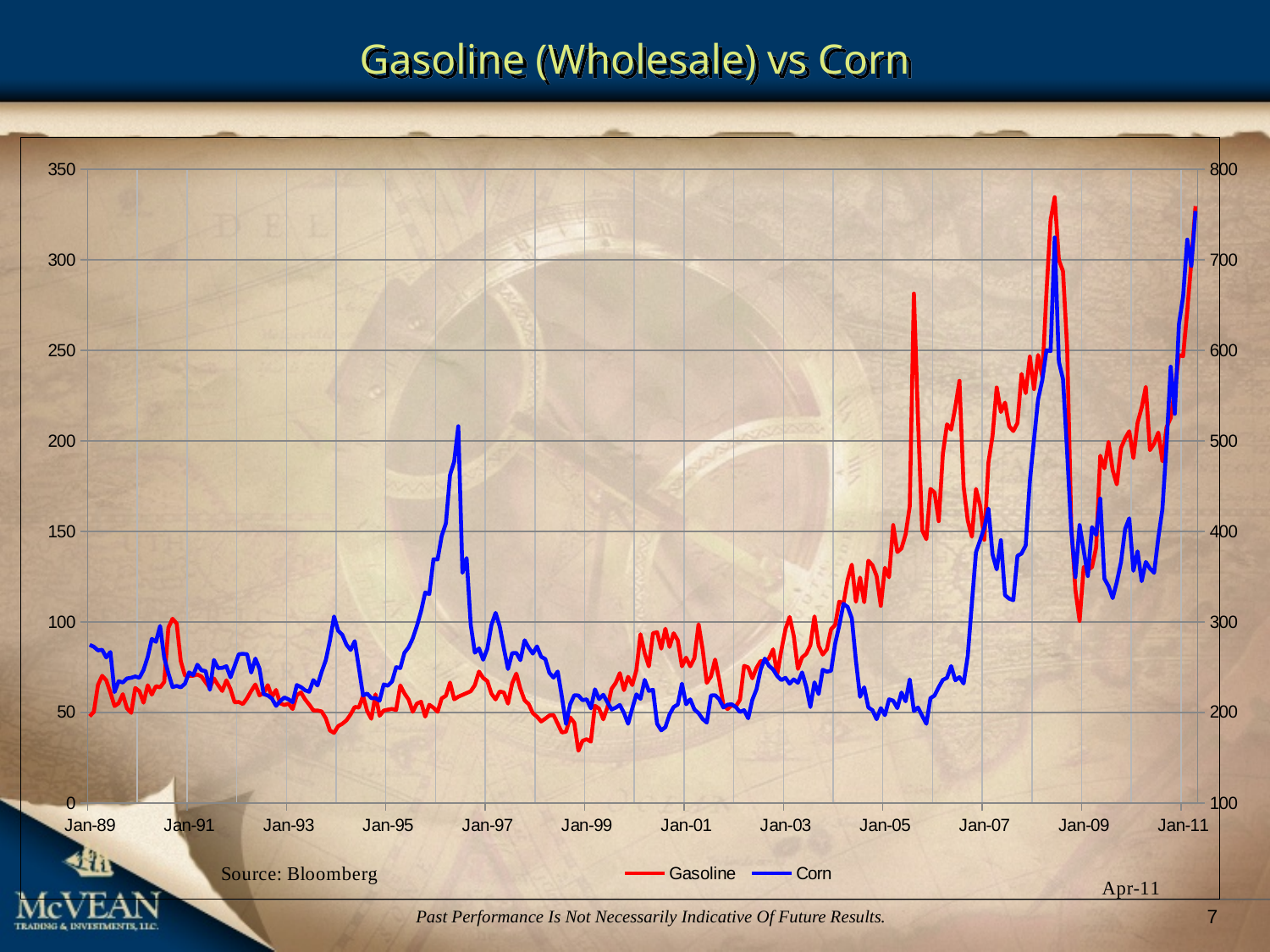
What kind of chart is shown on the slide? line chart How many date labels are shown on the x axis? 12 Is the Corn value at Jan-11 greater or less than 700 on the right axis? less Does the Corn series rise or fall between Jan-09 and Jan-11? rise Is the Gasoline value at Jan-11 greater or less than 300 on the left axis? less Is the Corn value around Jan-05 greater or less than 300 on the right axis? less Which colour is used for the Corn series? blue How many series does the legend list? 2 Overall, does the Gasoline series rise or fall from Jan-89 to Jan-11? rise What is the title of the chart? Gasoline (Wholesale) vs Corn